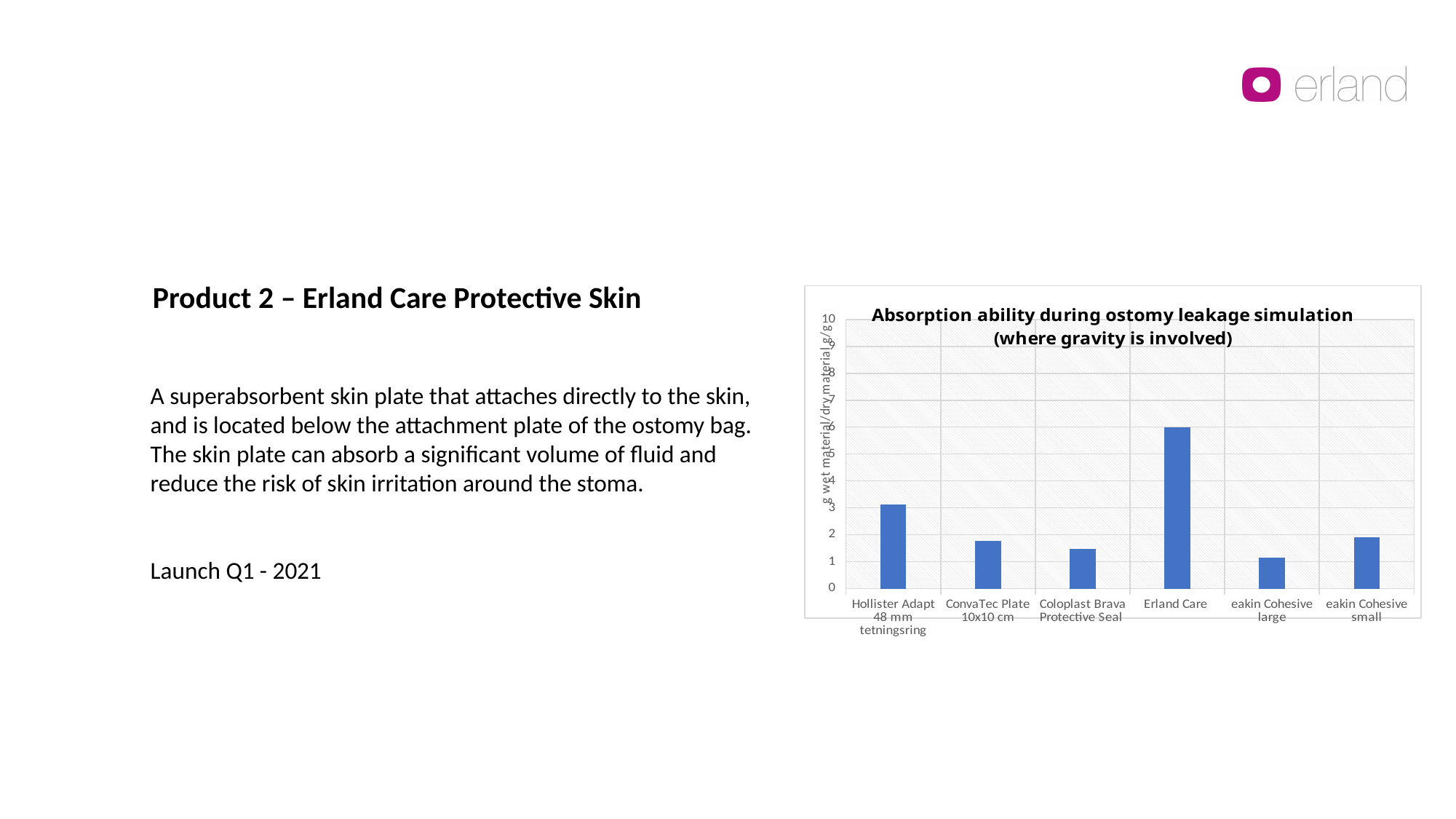
Which has a higher value, Erland Care or ConvaTec Plate 10x10 cm? Erland Care Which product has the highest absorption ability in the chart? Erland Care Is the value for Erland Care greater or less than 5? greater Is the value for Hollister Adapt 48 mm tetningsring greater or less than 2? greater Is the value for ConvaTec Plate 10x10 cm greater or less than 2? less Which product has the lowest absorption ability in the chart? eakin Cohesive large What is the title of the chart? Absorption ability during ostomy leakage simulation (where gravity is involved) How many products (categories) are shown on the x axis of the chart? 6 Which has a higher value, Hollister Adapt 48 mm tetningsring or eakin Cohesive small? Hollister Adapt 48 mm tetningsring What kind of chart is shown on the slide? Bar chart